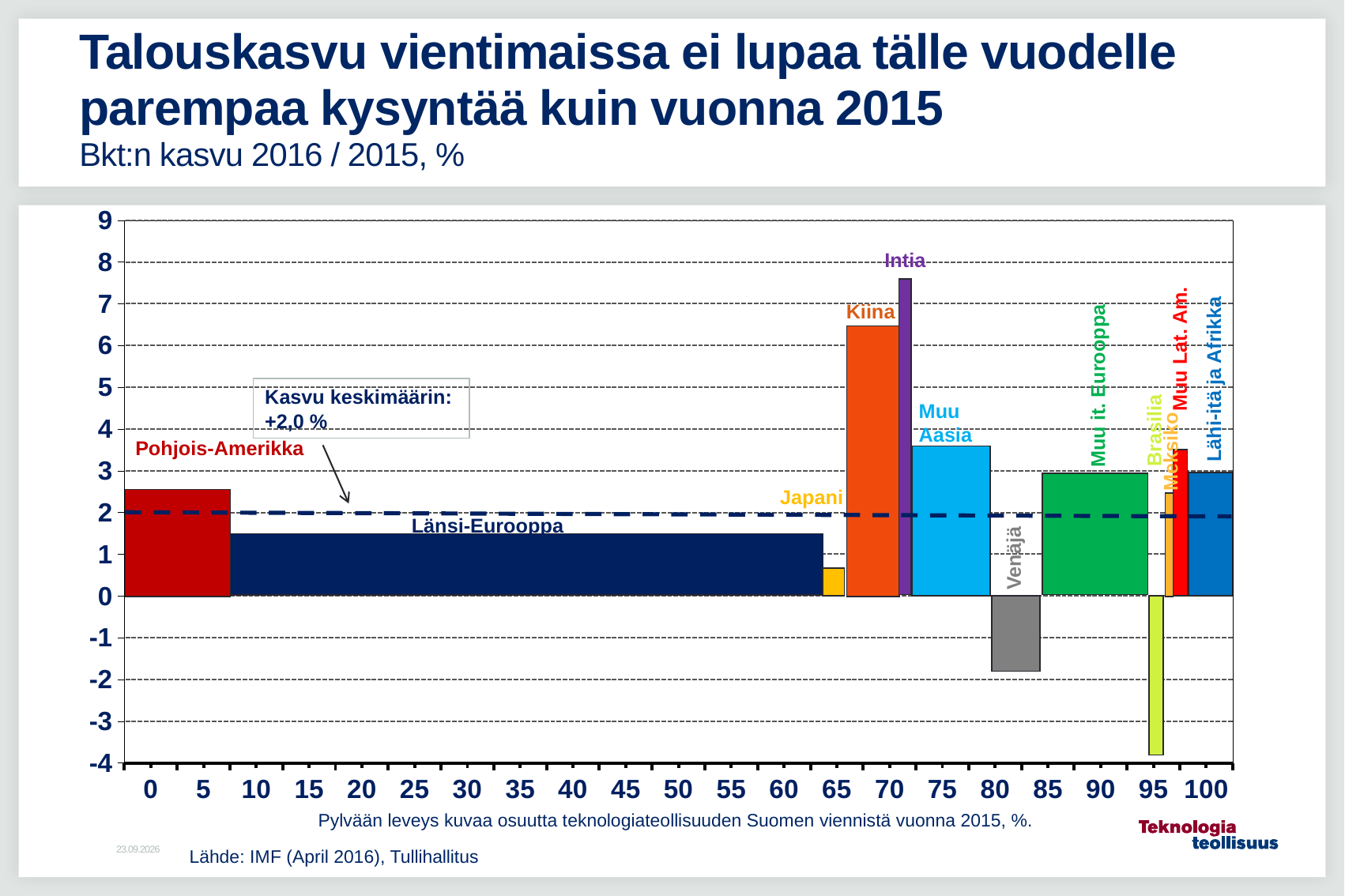
What kind of chart is shown on the slide? bar chart What is the average growth (Kasvu keskimäärin) shown in the chart annotation? +2,0 % Is the value for Länsi-Eurooppa greater or less than 2? less Which category has the highest GDP growth value in the chart? Intia Which has the larger value, Kiina or Muu Aasia? Kiina According to the note below the chart, what does the width of each bar represent? Share of Finnish technology industry exports in 2015, % Is the value for Kiina greater or less than 6? greater Is the value for Venäjä greater or less than -1? less Which has the larger value, Pohjois-Amerikka or Länsi-Eurooppa? Pohjois-Amerikka Which category has the lowest GDP growth value in the chart? Brasilia How many categories (bars) are shown in the chart? 12